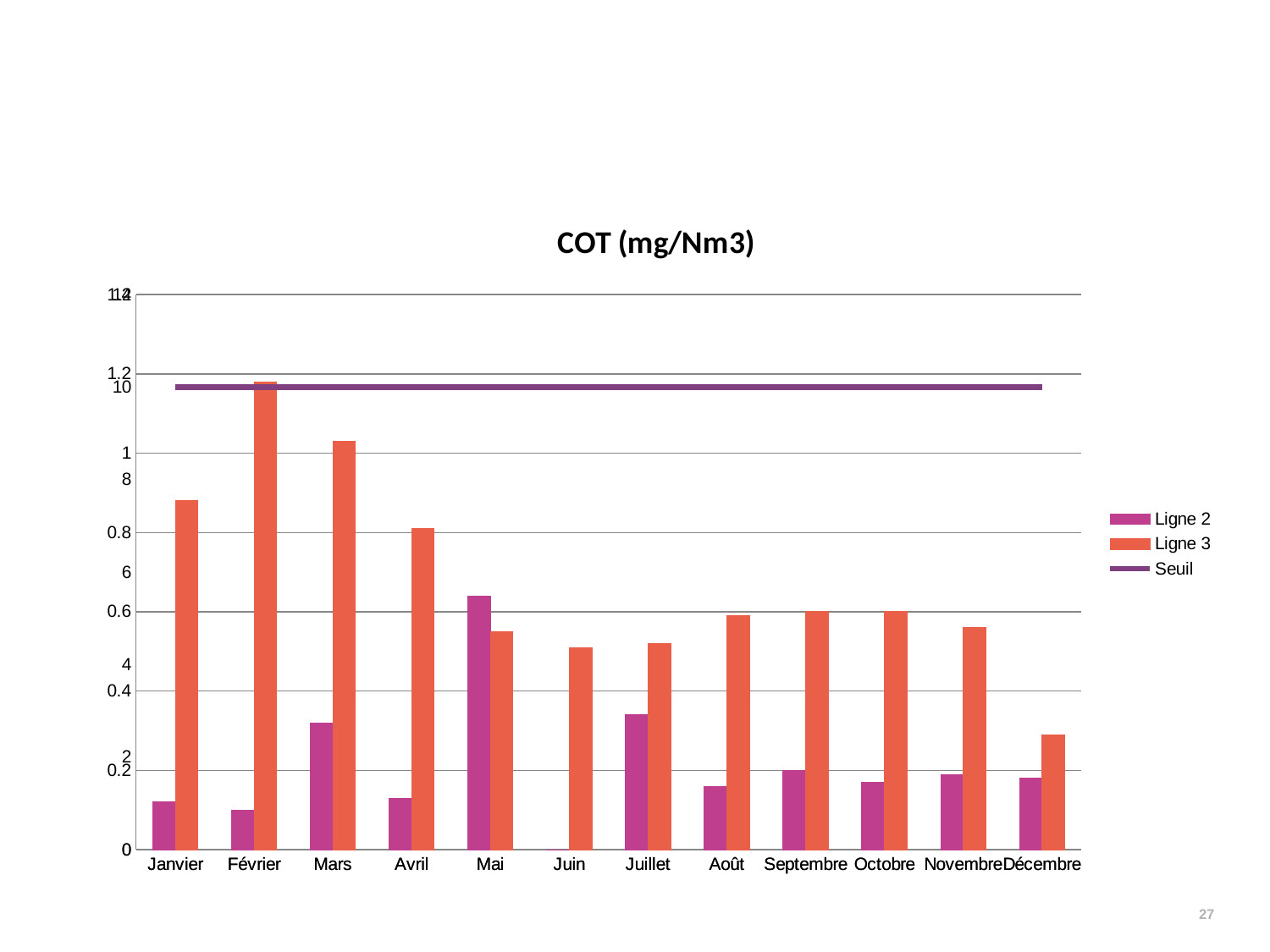
In which month is the Ligne 3 value lowest? Décembre For Ligne 3, which month has the larger value, Janvier or Avril? Janvier What kind of chart is shown on the slide? combination bar and line chart Which legend entry is drawn as a horizontal line rather than bars? Seuil In which month is the Ligne 2 value highest? Mai How many months are shown on the x axis? 12 Do the Ligne 3 values rise or fall from Février to Juin? fall In Mai, which series has the larger value, Ligne 2 or Ligne 3? Ligne 2 How many series does the legend list? 3 What is the title of the chart? COT (mg/Nm3) In which month is the Ligne 3 value highest? Février In which month is the Ligne 2 value lowest? Juin